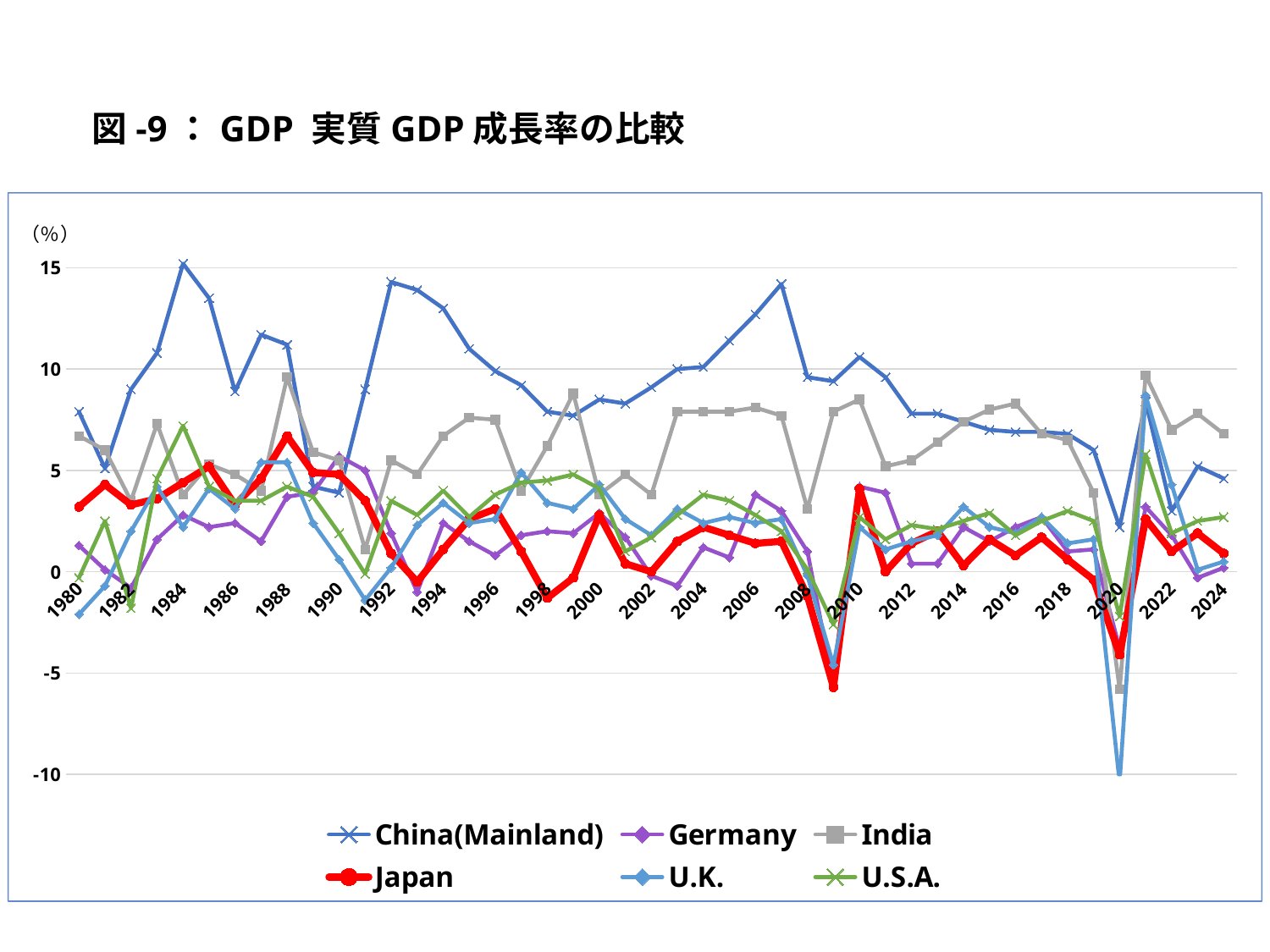
Is the value for U.K. in 2020 greater or less than -5? less In 2007, which has the higher value, China(Mainland) or India? China(Mainland) How many series does the legend list? 6 Is the value for Japan in 2020 greater or less than 0? less What is the title of the chart? 図-9： GDP 実質GDP成長率の比較 Is the value for China(Mainland) in 1984 greater or less than 10? greater What kind of chart is shown on the slide? line chart Does the value for China(Mainland) rise or fall from 2010 to 2015? fall Which series has the highest value in 1992? China(Mainland) In 2020, which has the lower value, U.K. or Japan? U.K.